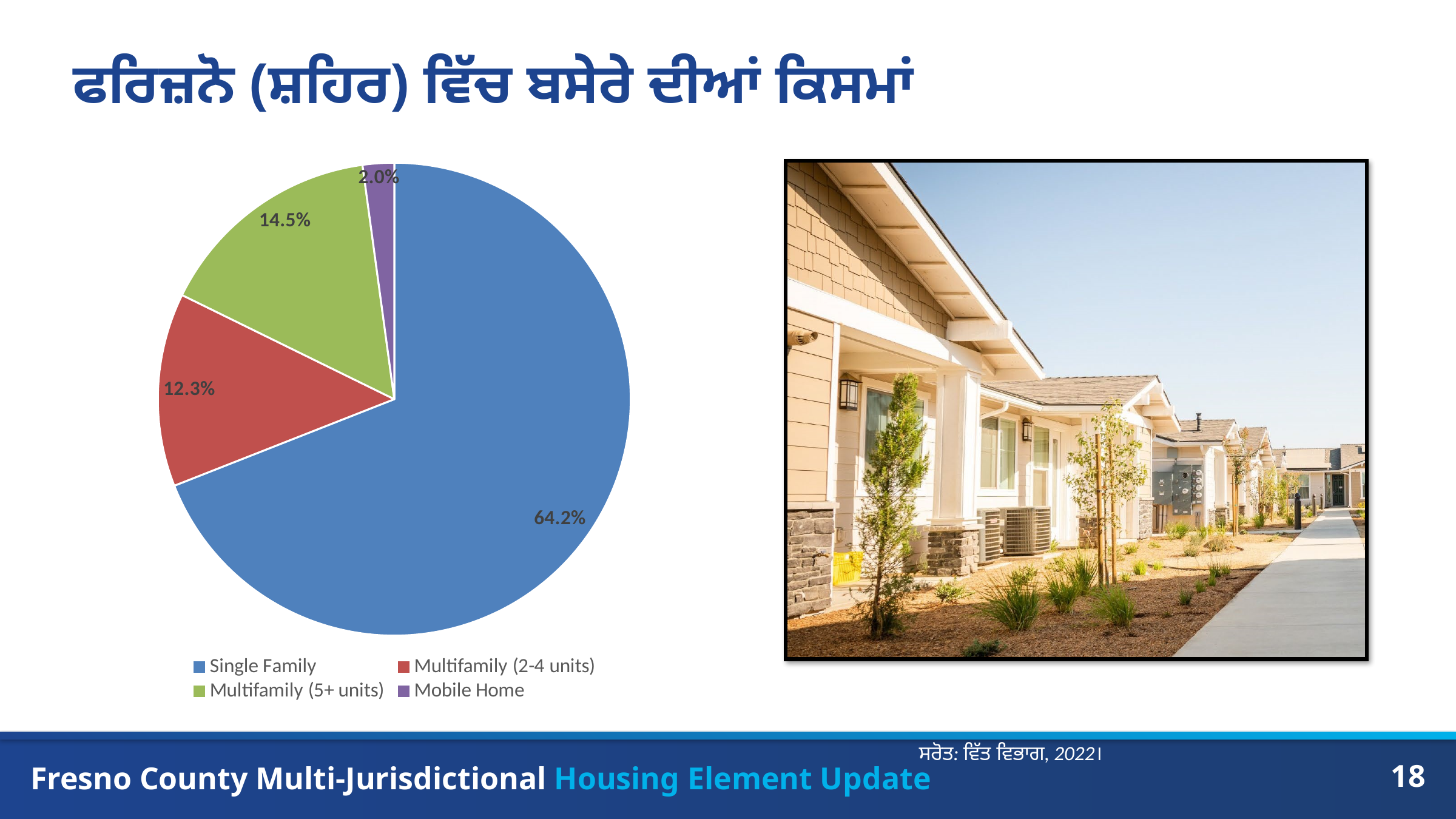
Which category has the largest share of the pie? Single Family Which is larger, the share for Multifamily (5+ units) or Multifamily (2-4 units)? Multifamily (5+ units) What share of the pie does Multifamily (2-4 units) represent? 12.3% What colour is the Mobile Home slice in the pie chart? Purple How many categories does the pie chart show? 4 What share of the pie does Single Family represent? 64.2% What kind of chart is shown on the slide? Pie chart What share of the pie does Mobile Home represent? 2.0% What is the difference in percentage points between Single Family and Multifamily (5+ units)? 49.7 What share of the pie does Multifamily (5+ units) represent? 14.5% What is the difference in percentage points between Multifamily (5+ units) and Multifamily (2-4 units)? 2.2 Which category has the smallest share of the pie? Mobile Home